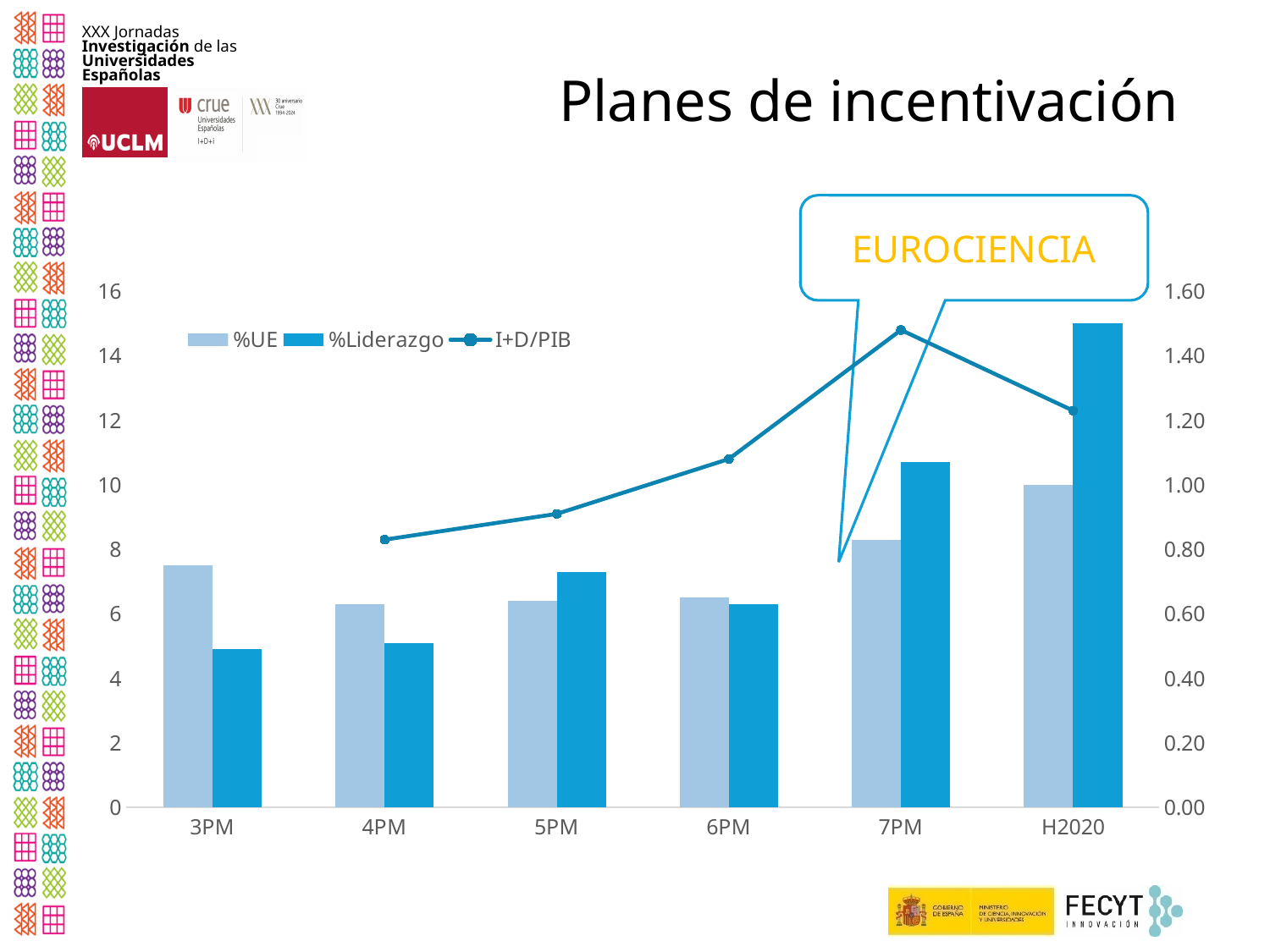
Is the I+D/PIB value for 7PM greater or less than 1.40? greater At 3PM, which is larger: %UE or %Liderazgo? %UE How many series does the chart legend list? 3 Is the %Liderazgo value for H2020 greater or less than 14? greater Which category has the highest %Liderazgo value? H2020 At 7PM, which is larger: %UE or %Liderazgo? %Liderazgo What kind of chart is shown on the slide? A combined bar and line chart At which category does the I+D/PIB line reach its highest point? 7PM What word is written in the callout box pointing at the 7PM bars? EUROCIENCIA Does the I+D/PIB line rise or fall from 4PM to 7PM? rise How many categories are shown on the x axis of the chart? 6 Which category has the highest %UE value? H2020